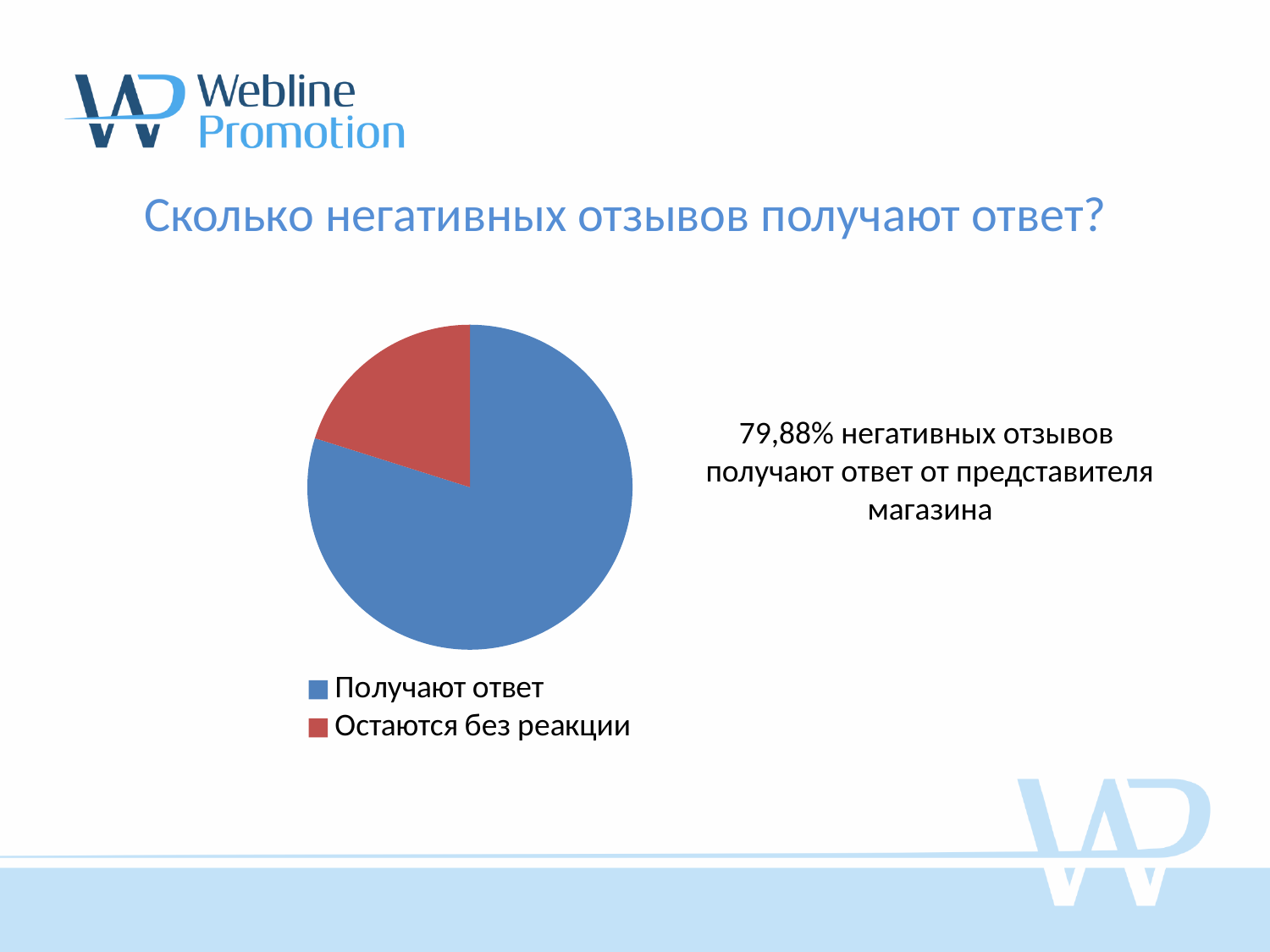
Is the share of "Остаются без реакции" greater or less than 50%? less What colour is the "Остаются без реакции" slice in the pie chart? red Which slice of the pie chart is the smallest? Остаются без реакции According to the slide, what share of negative reviews receive a response ("Получают ответ")? 79,88% What kind of chart is shown on the slide? pie chart Which is larger in the pie chart: "Получают ответ" or "Остаются без реакции"? Получают ответ Which slice of the pie chart is the largest? Получают ответ How many slices does the pie chart have? 2 Is the share of "Получают ответ" greater or less than 50%? greater How many entries does the legend of the pie chart list? 2 What is the title of the slide above the pie chart? Сколько негативных отзывов получают ответ?